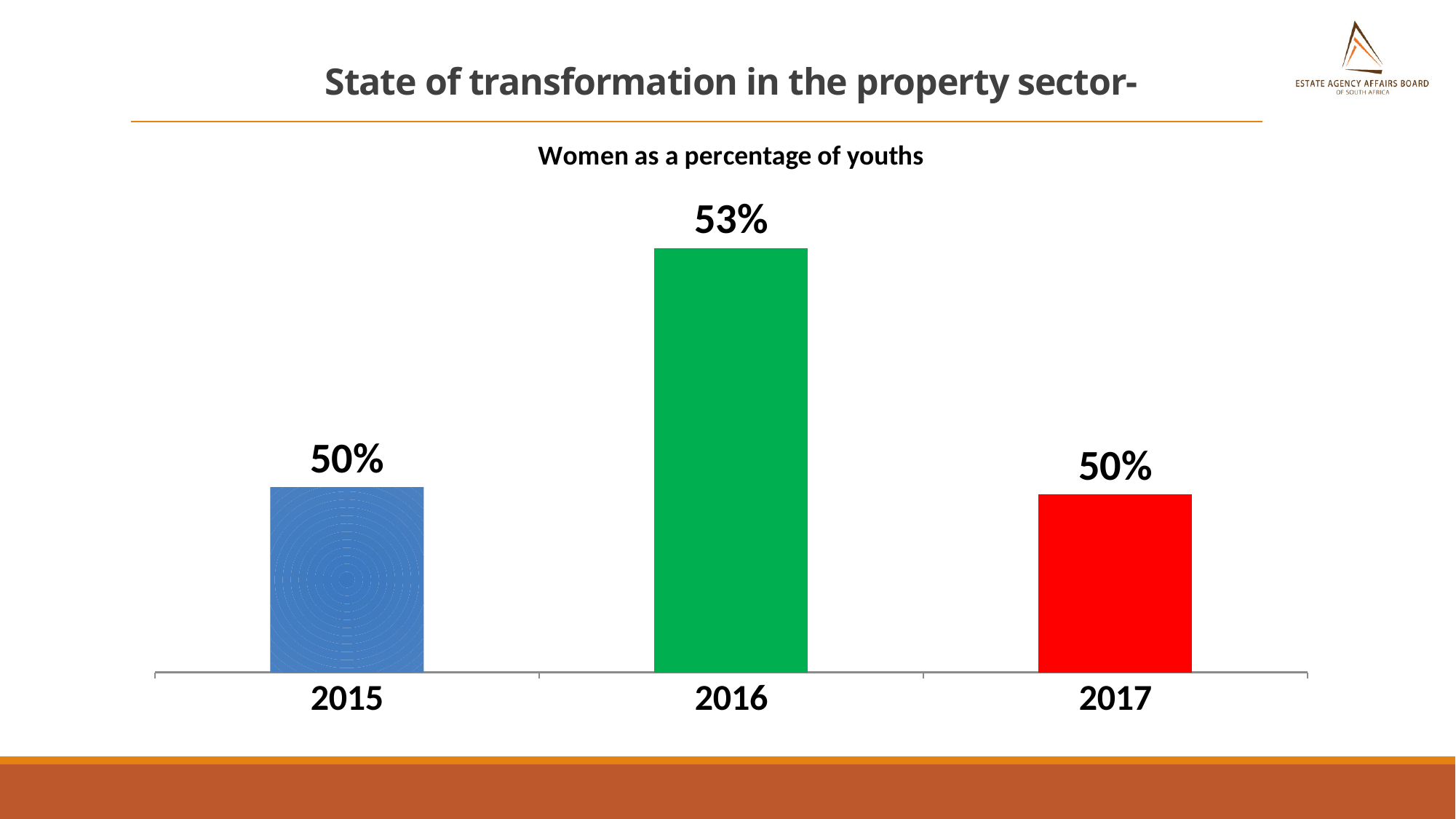
Which is larger, the value for 2016 or the value for 2017? 2016 What kind of chart is shown on the slide? bar chart What colour is the bar for 2016? green What is the value for 2017? 50% What is the title of the chart? Women as a percentage of youths What is the value for 2016? 53% How many years are shown on the x axis? 3 What is the value for 2015? 50% Which year has the highest value? 2016 What is the difference between the values for 2016 and 2017? 3% Does the value rise or fall from 2015 to 2016? rise What is the difference between the values for 2016 and 2015? 3%